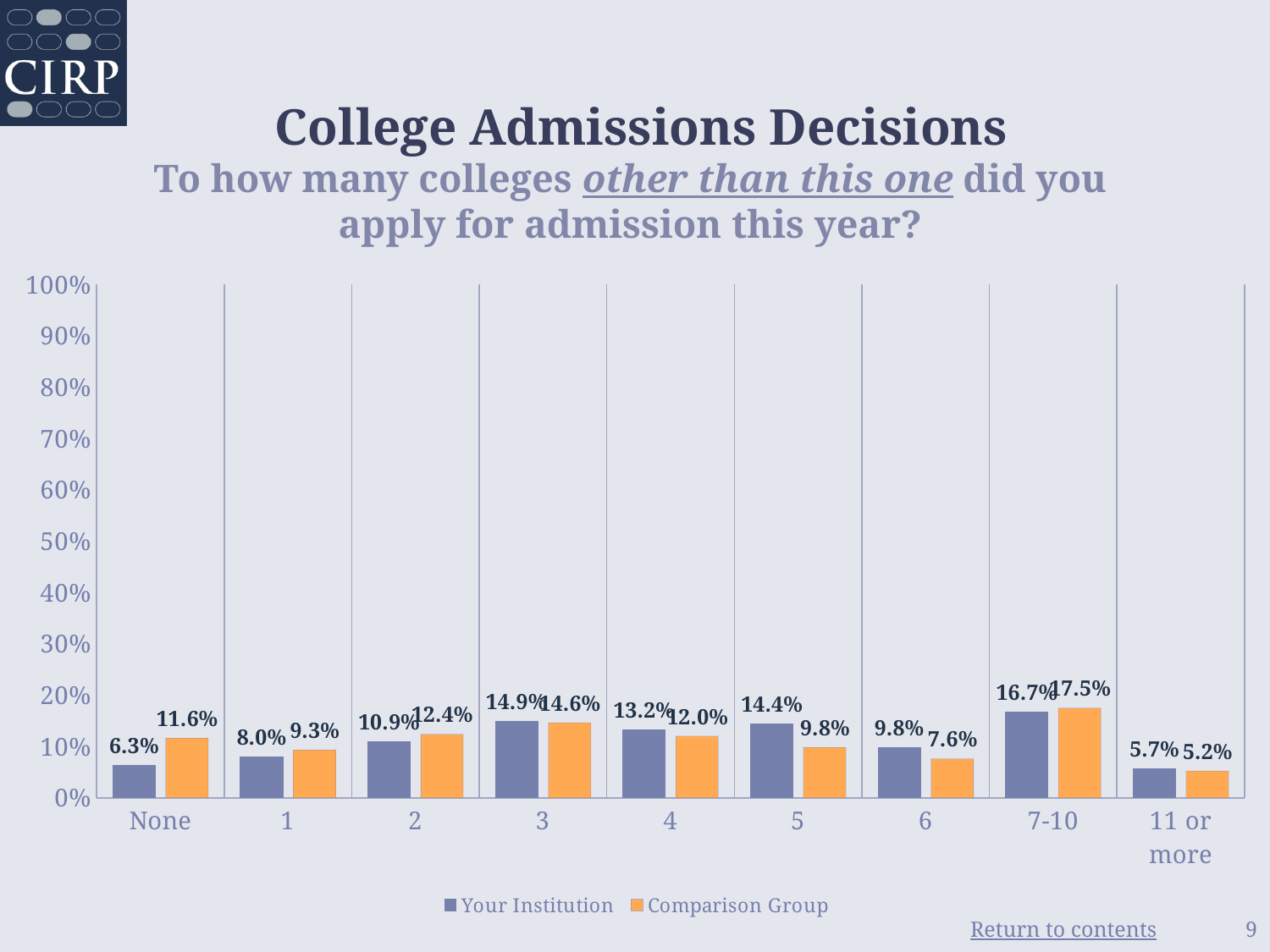
What is the difference between the Comparison Group and Your Institution values in the "None" category? 5.3 percentage points What kind of chart is shown on the slide? Bar chart What is the value for the Comparison Group in the "7-10" category? 17.5% What are the two series named in the legend? Your Institution and Comparison Group How many categories are shown on the x axis? 9 How many series does the legend list? 2 What is the value for Your Institution in the "None" category? 6.3% Which category has the highest value for Your Institution? 7-10 Which category has the lowest value for the Comparison Group? 11 or more Is the value for Your Institution in the "7-10" category greater or less than 20%? less In the "5" category, which series has the larger value, Your Institution or Comparison Group? Your Institution What is the value for Your Institution in the "5" category? 14.4%